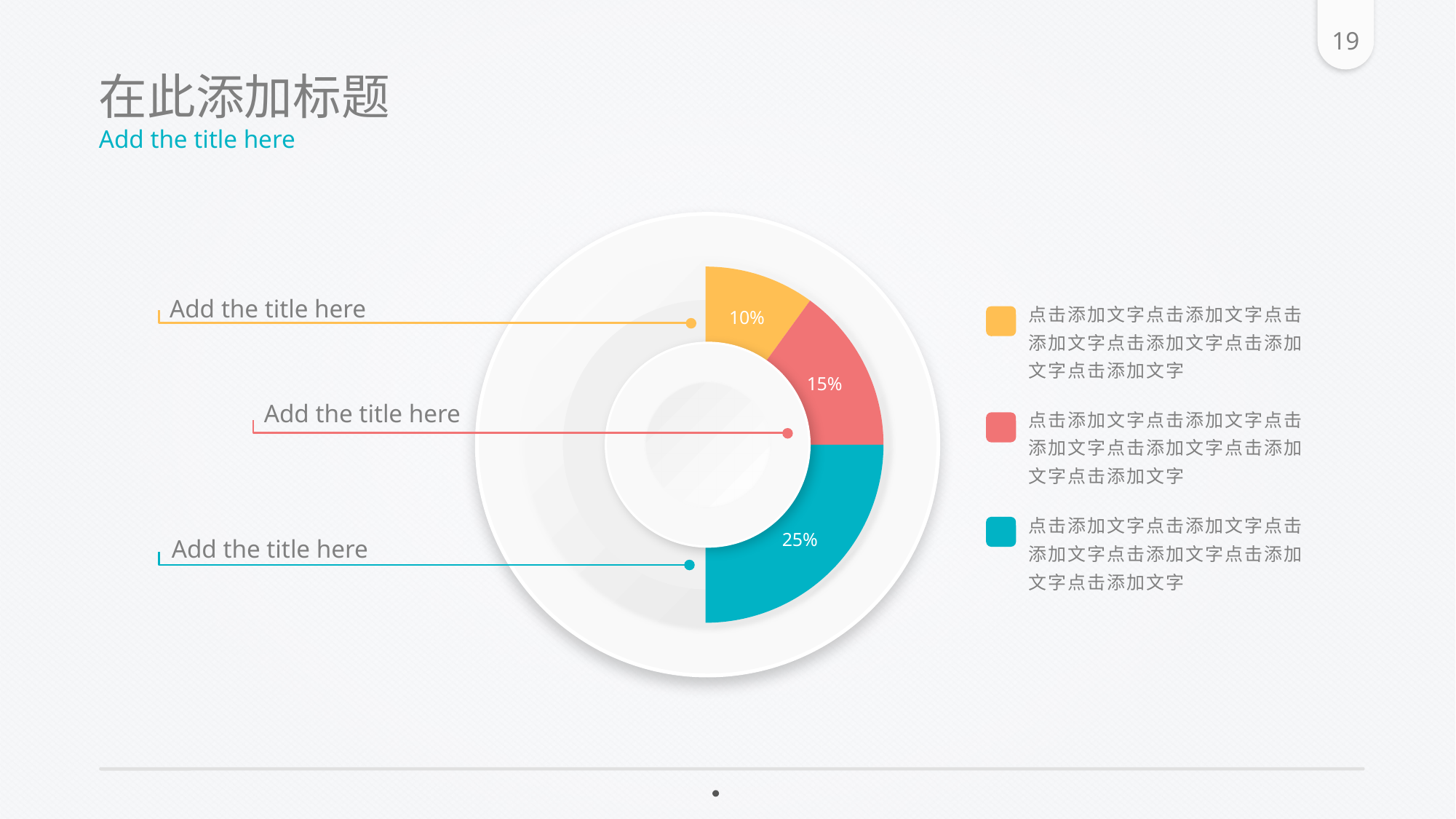
What value is shown on the yellow segment of the chart? 10% Which coloured segment of the chart has the highest value? teal What is the difference between the teal segment's value and the yellow segment's value? 15% What is the sum of the three percentage values shown on the chart? 50% What value is shown on the teal segment of the chart? 25% Which is larger, the red segment's value or the teal segment's value? teal What value is shown on the red segment of the chart? 15% How many entries does the legend on the right list? 3 What is the difference between the red segment's value and the yellow segment's value? 5% What kind of chart is shown on the slide? doughnut (pie) chart How many data segments are shown in the chart? 3 Which coloured segment of the chart has the lowest value? yellow